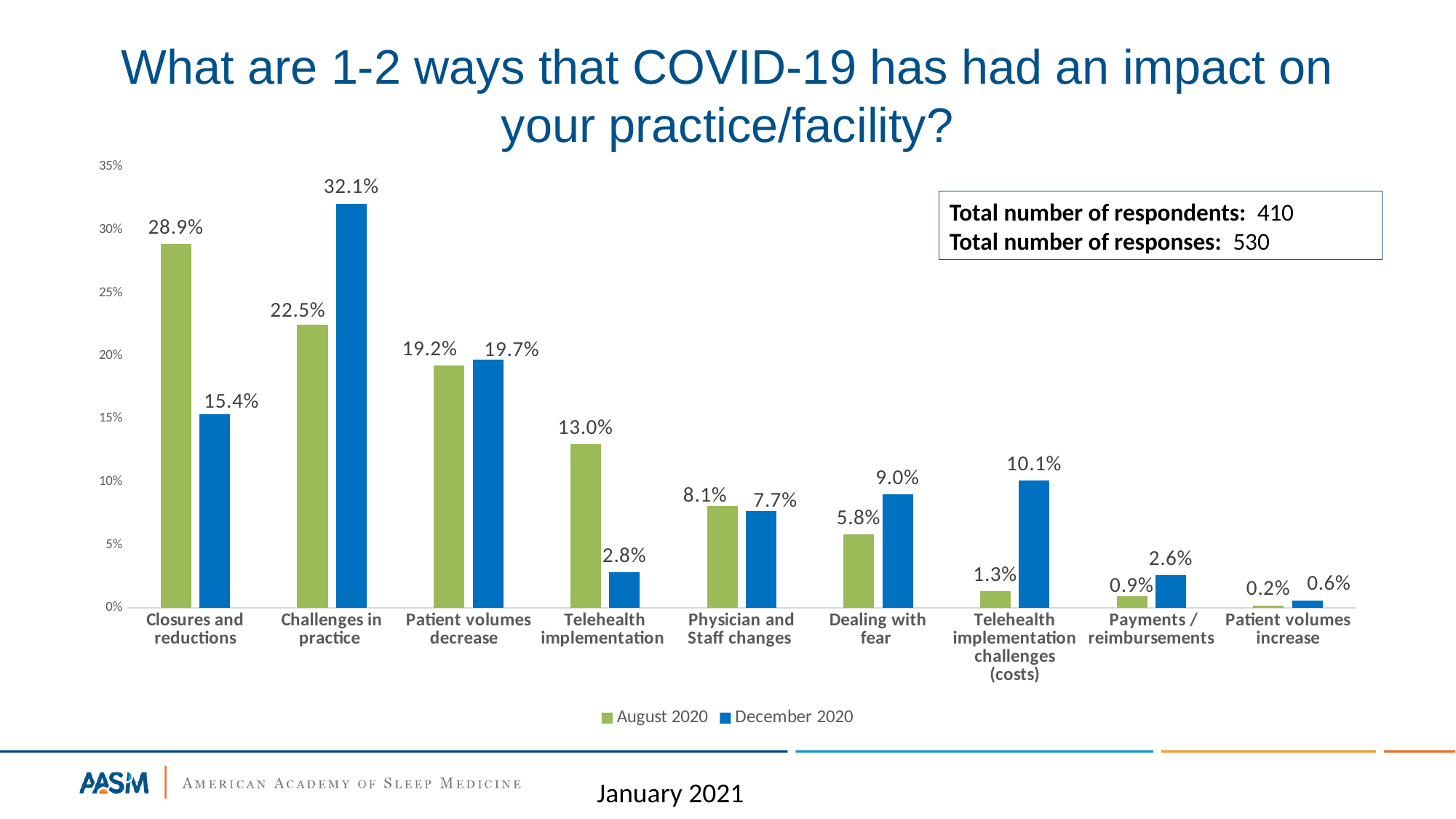
What is the December 2020 value for Telehealth implementation challenges (costs)? 10.1% Is the December 2020 value for Dealing with fear greater or less than 5%? greater What is the August 2020 value for Telehealth implementation? 13.0% How many series does the legend list? 2 What is the difference between the August 2020 and December 2020 values for Closures and reductions? 13.5% Which category has the highest August 2020 value? Closures and reductions What kind of chart is shown on the slide? bar chart Which category has the lowest December 2020 value? Patient volumes increase What is the December 2020 value for Challenges in practice? 32.1% What is the total number of respondents stated on the slide? 410 How many categories are shown on the x axis? 9 Which is larger for Physician and Staff changes: the August 2020 value or the December 2020 value? August 2020